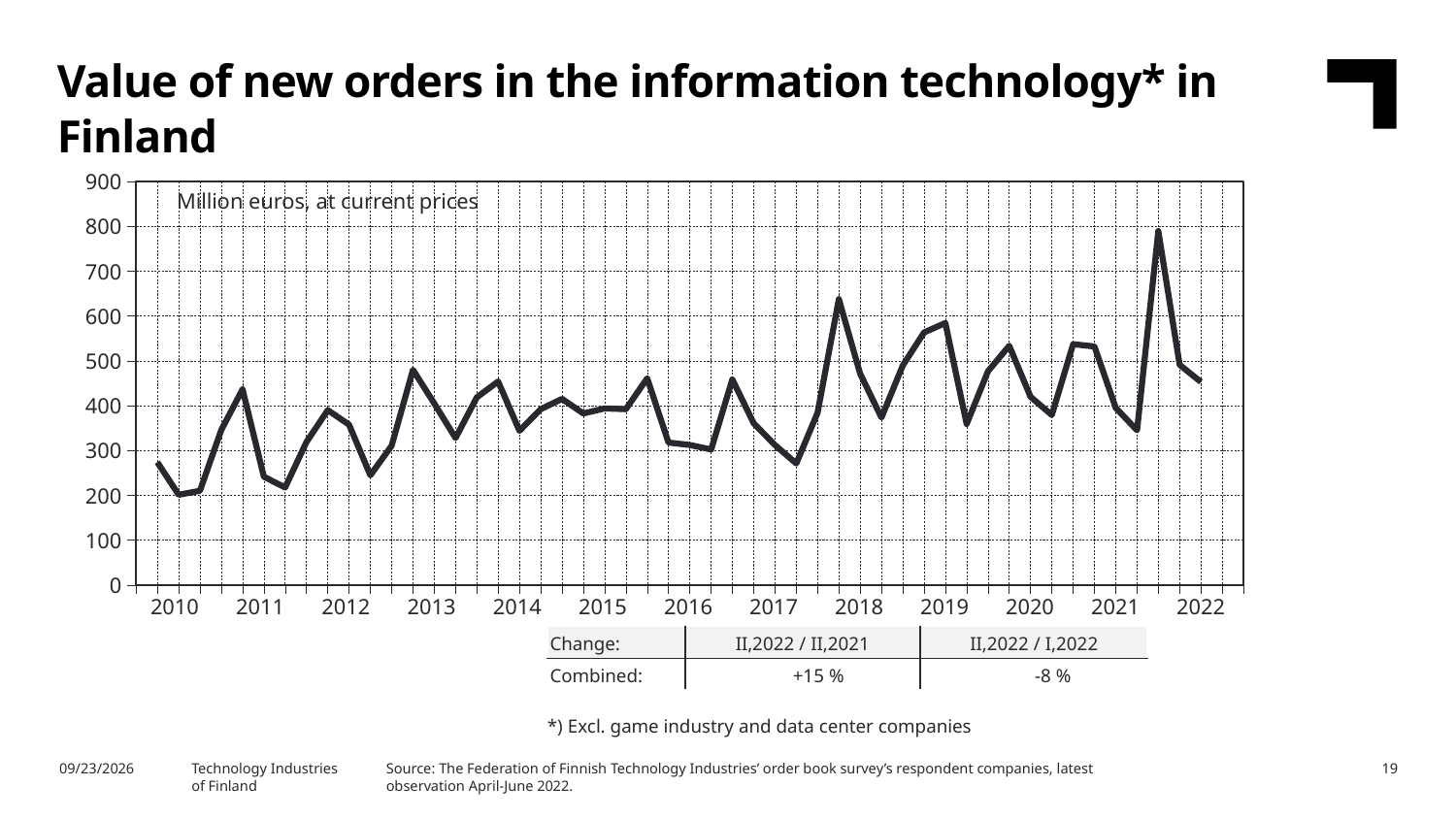
Is the peak value in 2021 larger than the peak value in 2018? yes Is the lowest value of the line in 2010 greater or less than 300? less Is the peak value in 2018 greater or less than 600? greater How many years are labelled on the x axis of the chart? 13 What kind of chart is shown on the slide? line chart In which year does the line reach its highest peak? 2021 What unit is stated inside the chart area? Million euros, at current prices What is the combined change for II,2022 / II,2021 shown in the table below the chart? +15 % Is the highest peak of the line, in 2021, greater or less than 700? greater Does the line rise or fall from its 2021 peak to the end of 2022? fall